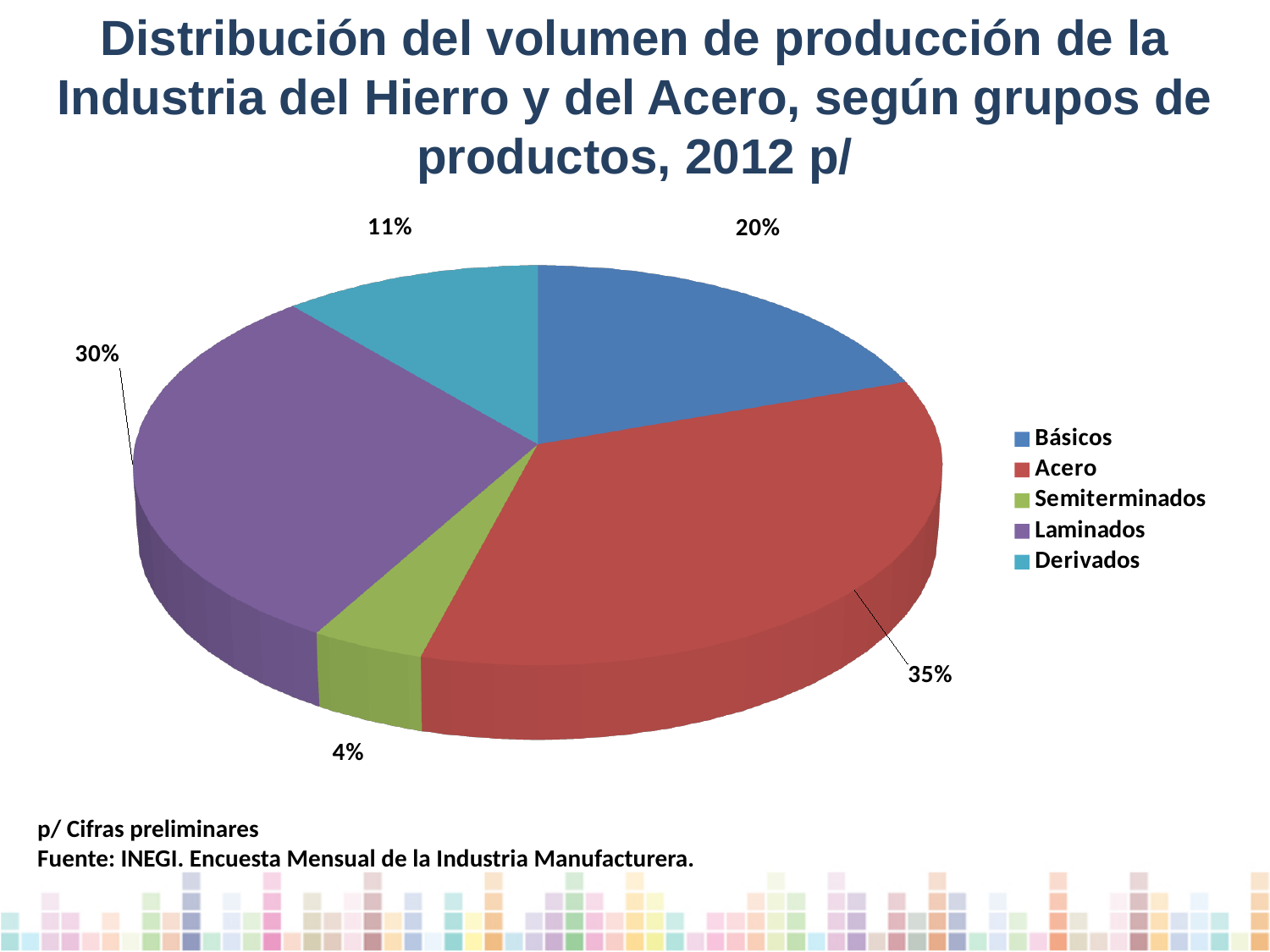
What share of the pie does Derivados have? 11% What share of the pie does Laminados have? 30% What share of the pie does Semiterminados have? 4% What kind of chart is shown on the slide? Pie chart Which has a larger share, Básicos or Derivados? Básicos What colour represents Laminados in the chart? Purple What is the difference in percentage points between the shares of Acero and Laminados? 5 Which product group has the largest share of production volume? Acero How many product groups are shown in the pie chart? 5 Which product group has the smallest share of production volume? Semiterminados